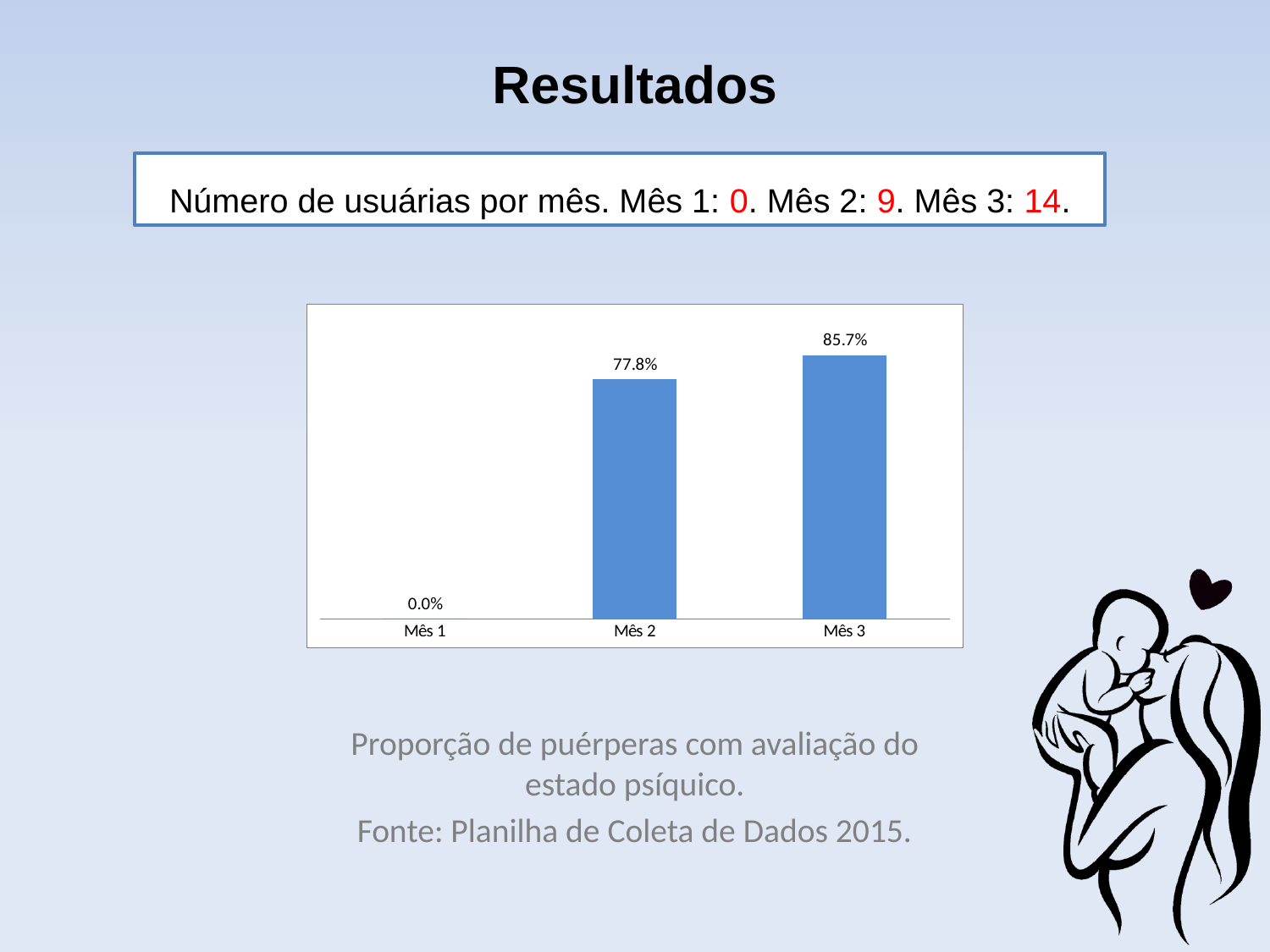
According to the caption below the chart, what proportion does the chart show? Proporção de puérperas com avaliação do estado psíquico What is the value for Mês 2? 77.8% Which is larger, the value for Mês 2 or the value for Mês 3? Mês 3 What colour are the bars in the chart? Blue Which month has the lowest value? Mês 1 Do the values rise or fall from Mês 1 to Mês 3? Rise How many months are shown on the x axis? 3 What is the value for Mês 3? 85.7% What is the difference between the values for Mês 3 and Mês 2? 7.9% What kind of chart is shown on the slide? Bar chart Which month has the highest value? Mês 3 What is the value for Mês 1? 0.0%